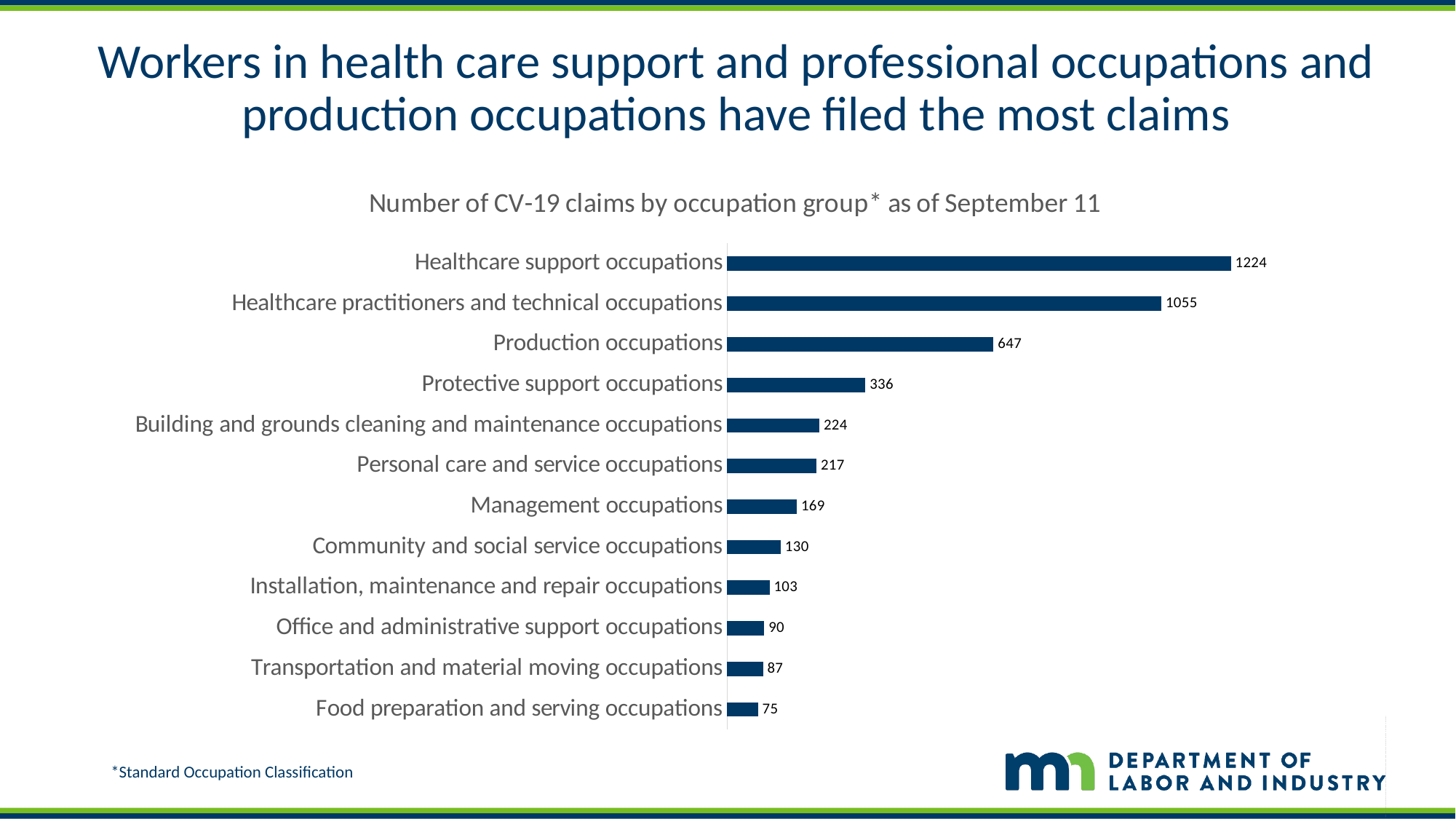
Which has more claims: Community and social service occupations or Installation, maintenance and repair occupations? Community and social service occupations Which occupation group has the highest number of claims? Healthcare support occupations What is the title of the chart? Number of CV-19 claims by occupation group* as of September 11 Which occupation group has the lowest number of claims? Food preparation and serving occupations What is the number of claims for Production occupations? 647 How many CV-19 claims were filed by workers in Healthcare support occupations? 1224 What type of chart is shown on the slide? Bar chart What does the asterisk in the chart title refer to, according to the footnote? Standard Occupation Classification What is the difference in claims between Healthcare support occupations and Healthcare practitioners and technical occupations? 169 How many occupation groups are shown in the chart? 12 What is the difference in claims between Protective support occupations and Building and grounds cleaning and maintenance occupations? 112 How many claims were filed by Management occupations? 169